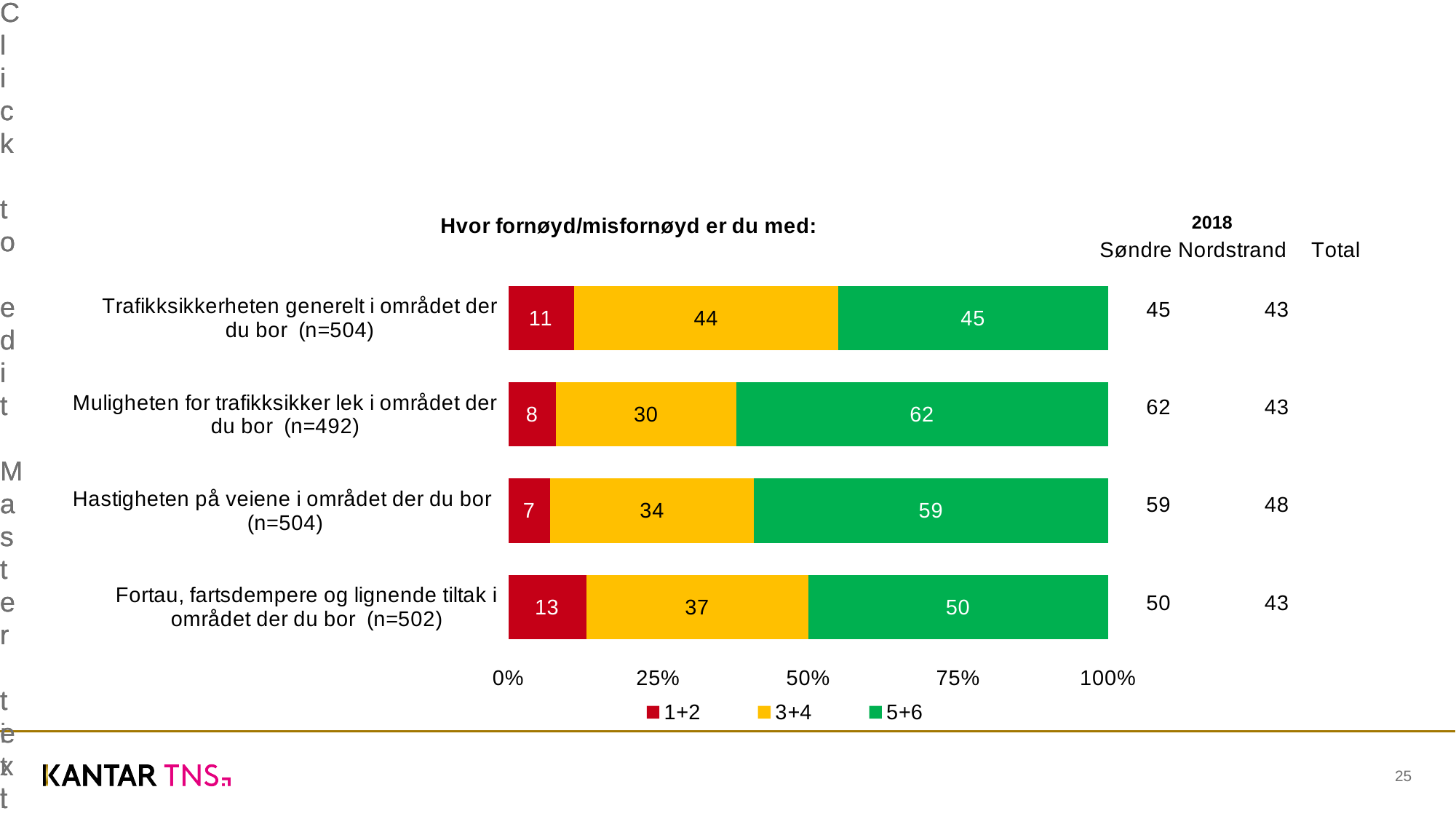
What is the title of the chart? Hvor fornøyd/misfornøyd er du med: Which category has the highest value for the 5+6 series? Muligheten for trafikksikker lek i området der du bor (n=492) What kind of chart is shown on the slide? Stacked bar chart Which is larger: the 3+4 value for "Fortau, fartsdempere og lignende tiltak i området der du bor (n=502)" or the 3+4 value for "Hastigheten på veiene i området der du bor (n=504)"? Fortau, fartsdempere og lignende tiltak i området der du bor (n=502) How many series does the legend list? 3 Which category has the lowest value for the 1+2 series? Hastigheten på veiene i området der du bor (n=504) What is the difference between the 5+6 values for "Hastigheten på veiene i området der du bor (n=504)" and "Trafikksikkerheten generelt i området der du bor (n=504)"? 14 How many categories are plotted in the chart? 4 What is the Total value shown to the right of the chart for "Hastigheten på veiene i området der du bor (n=504)"? 48 What is the value of the 5+6 series for "Muligheten for trafikksikker lek i området der du bor (n=492)"? 62 What is the value of the 3+4 series for "Trafikksikkerheten generelt i området der du bor (n=504)"? 44 What is the value of the 1+2 series for "Fortau, fartsdempere og lignende tiltak i området der du bor (n=502)"? 13